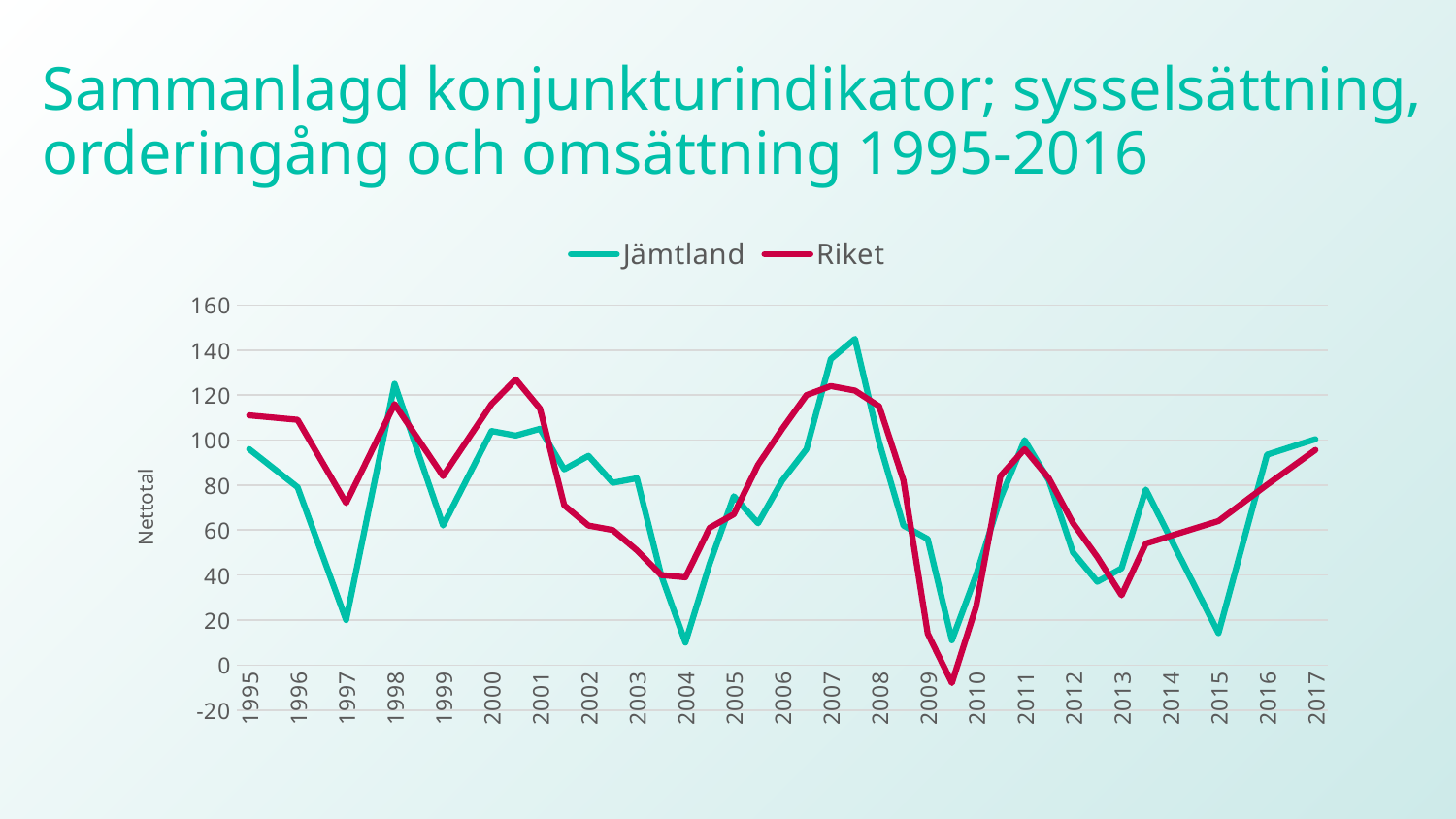
In which year does the Jämtland series reach its highest value? 2007 In which year does the Riket series reach its lowest value? 2009 How many years are labelled along the x axis? 23 What is the label on the vertical axis? Nettotal How many series does the legend list? 2 What kind of chart is shown on the slide? Line chart In 1997, which series has the larger value, Jämtland or Riket? Riket Is the value for Jämtland in 2007 greater or less than 120? greater Is the value for Jämtland in 2004 greater or less than 20? less What are the two series named in the legend? Jämtland and Riket Does the Jämtland series rise or fall from 2015 to 2017? Rise